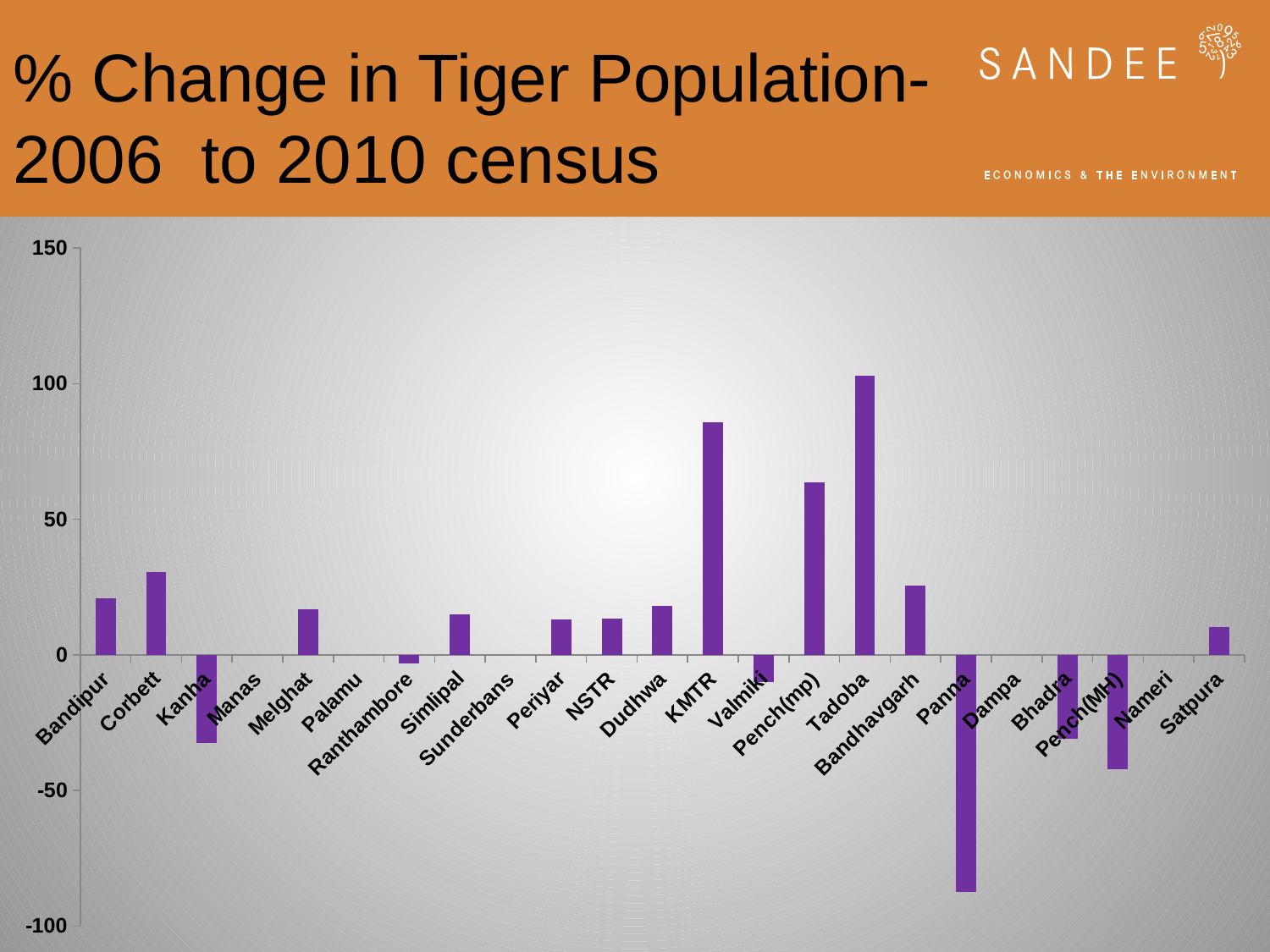
Which tiger reserve has the lowest % change in tiger population? Panna How many tiger reserves (categories) are shown on the x axis of the chart? 23 Is the value for Kanha greater or less than 0? less Is the value for KMTR greater or less than 50? greater Which has the larger % change in tiger population, Corbett or Bandipur? Corbett Is the value for Pench(mp) greater or less than 50? greater Which has the larger % change in tiger population, KMTR or Pench(mp)? KMTR Which tiger reserve has the highest % change in tiger population? Tadoba What kind of chart is shown on the slide? bar chart What is the title of the chart on the slide? % Change in Tiger Population- 2006 to 2010 census Which has the lower % change in tiger population, Bhadra or Pench(MH)? Pench(MH)